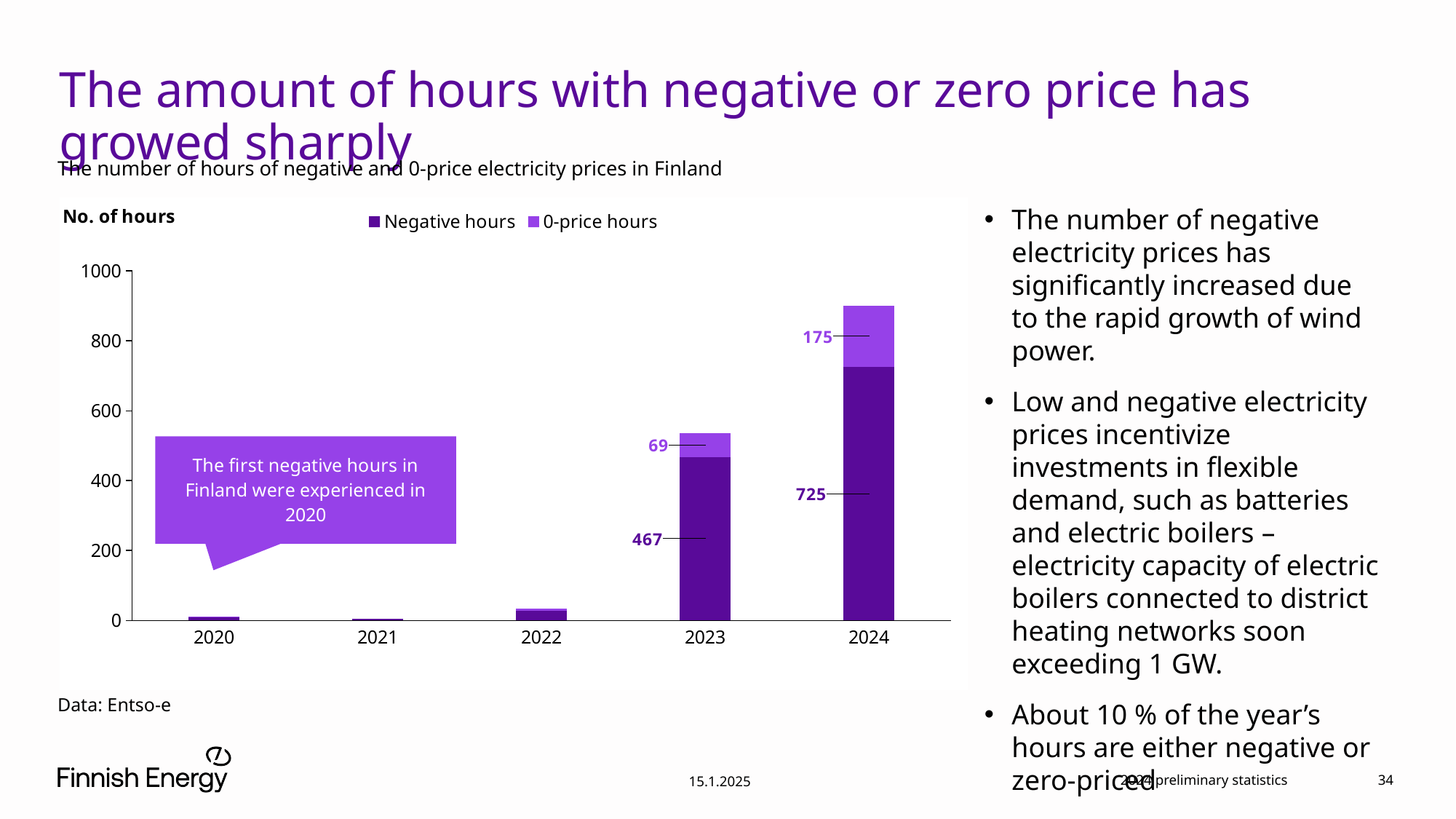
Is the value for Negative hours in 2022 greater or less than 200? less How many series does the legend list? 2 What is the value of 0-price hours in 2024? 175 What is the value of 0-price hours in 2023? 69 What is the value of Negative hours in 2023? 467 What is the difference in Negative hours between 2024 and 2023? 258 What is the total height of the stacked bar for 2024 (Negative hours plus 0-price hours)? 900 What is the total height of the stacked bar for 2023 (Negative hours plus 0-price hours)? 536 What is the value of Negative hours in 2024? 725 Which year has the highest number of Negative hours? 2024 What kind of chart is shown on the slide? Stacked bar chart How many years are shown on the x axis? 5